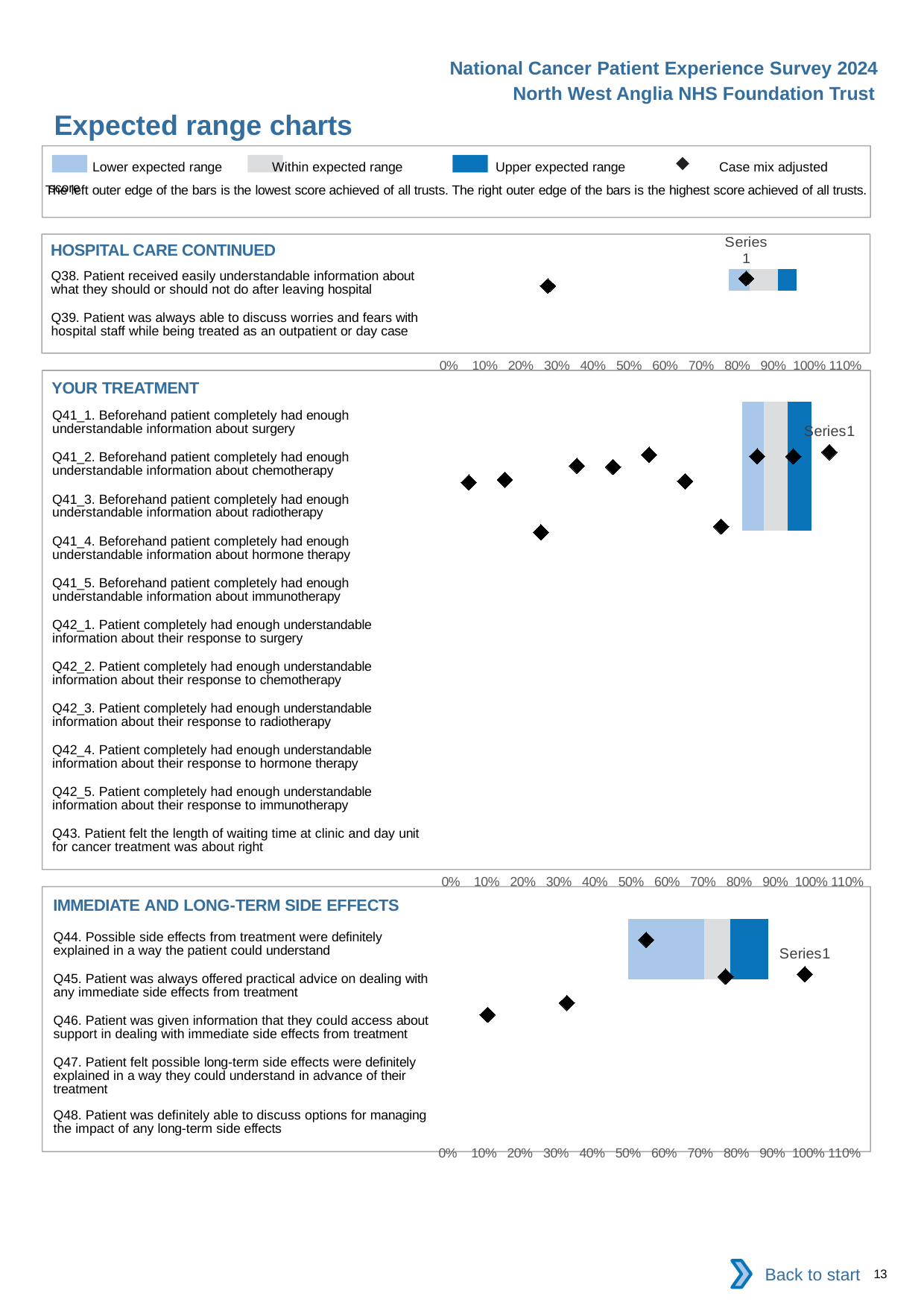
In the IMMEDIATE AND LONG-TERM SIDE EFFECTS chart, is the lowest plotted diamond marker greater or less than 20%? less What is the highest tick label shown on the x axis of the charts? 110% In the HOSPITAL CARE CONTINUED chart, how many questions are listed? 2 In the YOUR TREATMENT chart, is the lowest plotted diamond marker greater or less than 20%? less How many entries does the legend at the top of the slide list? 4 In the HOSPITAL CARE CONTINUED chart, is the leftmost plotted diamond marker greater or less than 40%? less In the YOUR TREATMENT chart, how many questions are listed? 11 What marker symbol does the legend use for the case mix adjusted score? A diamond In the IMMEDIATE AND LONG-TERM SIDE EFFECTS chart, how many questions are listed? 5